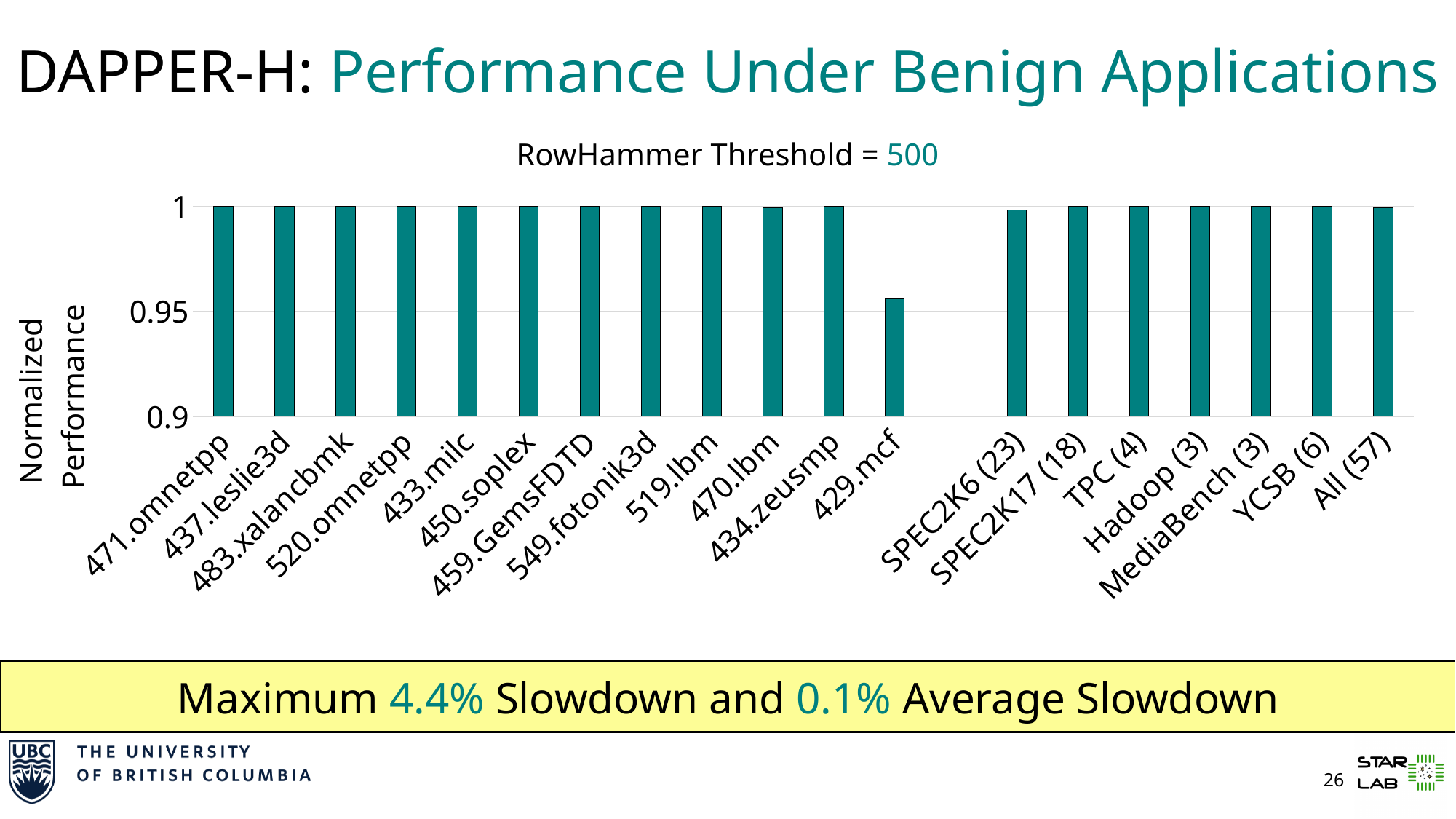
What is the lowest tick value shown on the vertical axis? 0.9 How many bars (categories) are plotted in the chart? 19 Is the normalized performance for 433.milc greater or less than 0.95? greater Which has the larger normalized performance, 429.mcf or SPEC2K6 (23)? SPEC2K6 (23) What is the highest tick value shown on the vertical axis? 1 Which has the larger normalized performance, 429.mcf or 450.soplex? 450.soplex Which category has the lowest normalized performance? 429.mcf What kind of chart is shown on the slide? bar chart What is the label of the vertical axis? Normalized Performance Is the normalized performance for 429.mcf greater or less than 1? less What is the title of the chart? RowHammer Threshold = 500 Is the normalized performance for All (57) greater or less than 0.95? greater